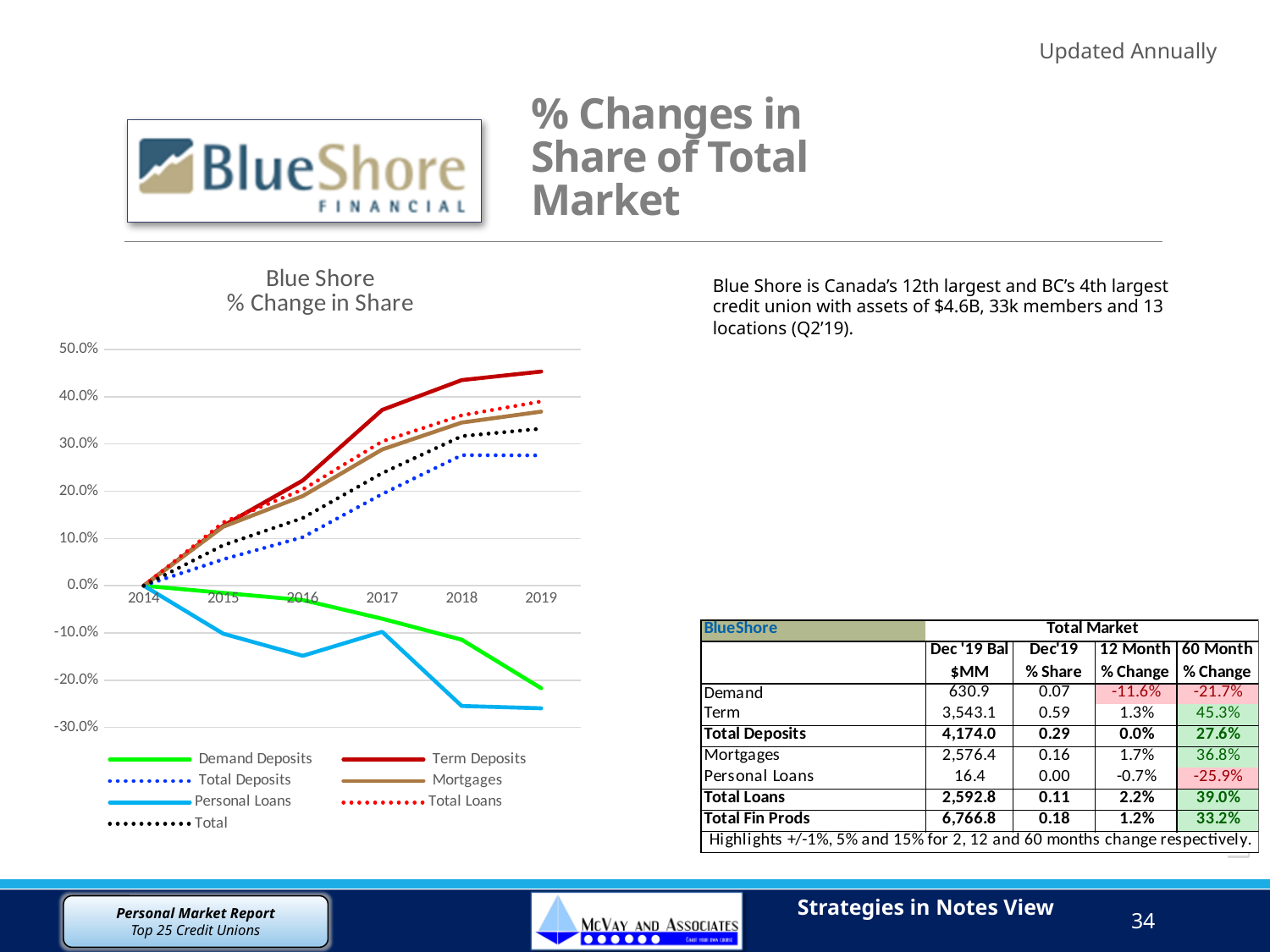
Does the Demand Deposits line rise or fall from 2014 to 2019? fall What is the value of all series in 2014? 0.0% How many series does the chart legend list? 7 What kind of chart is shown on the slide? line chart In 2019, which is larger: Term Deposits or Mortgages? Term Deposits How many years are shown along the x axis of the chart? 6 Does the Term Deposits line rise or fall from 2014 to 2019? rise What is the title of the chart? Blue Shore % Change in Share Is the value for Term Deposits in 2019 greater or less than 40.0%? greater Is the value for Personal Loans in 2019 greater or less than -20.0%? less Which series has the highest value in 2019? Term Deposits Which series has the lowest value in 2019? Personal Loans